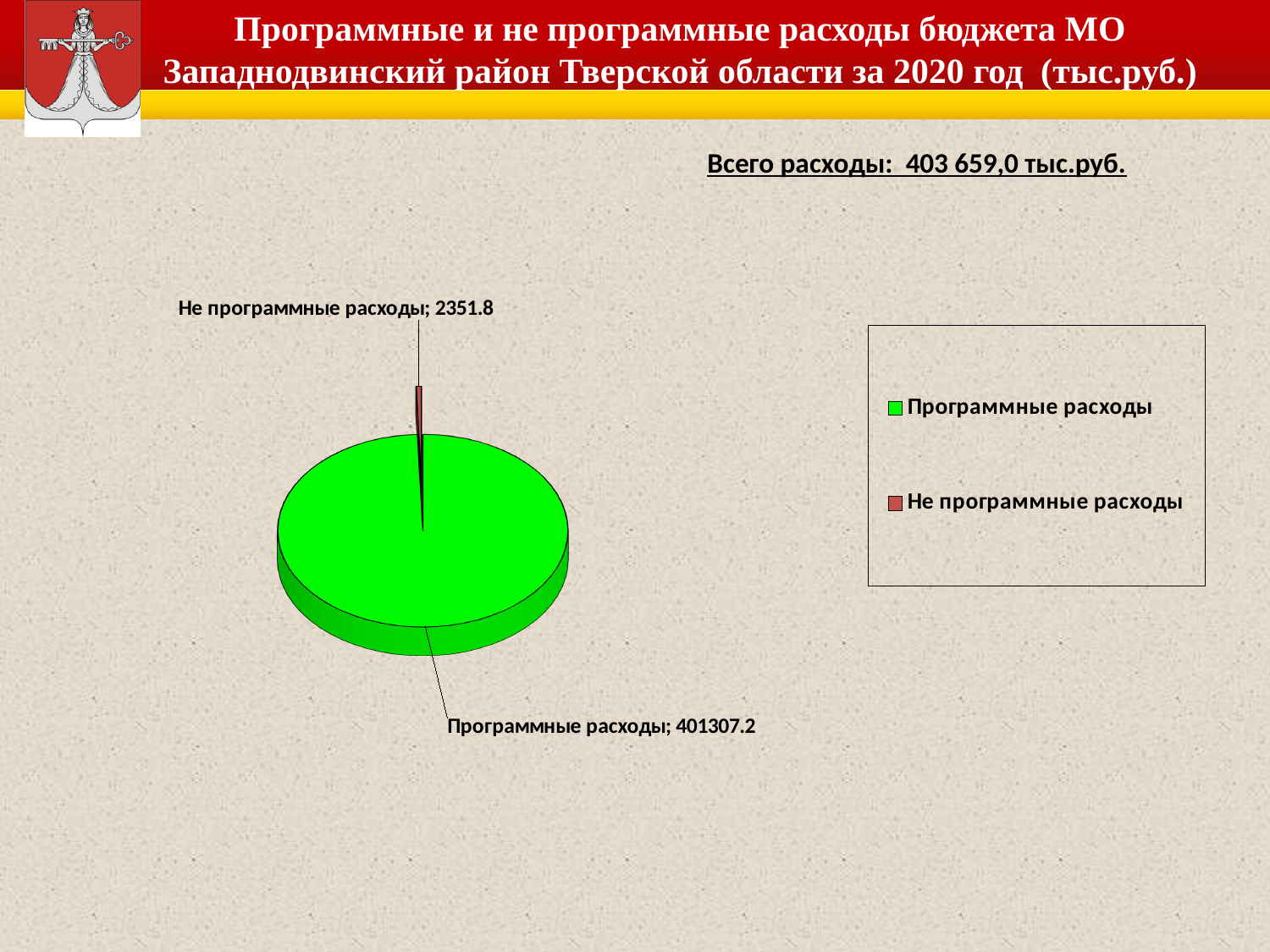
What is the value for Программные расходы? 401307.2 What is the difference between Программные расходы and Не программные расходы? 398955.4 Which is larger, Программные расходы or Не программные расходы? Программные расходы How many slices does the pie chart have? 2 How many entries does the legend list? 2 What colour is the slice for Программные расходы? green Which category has the smallest slice of the pie? Не программные расходы What colour is the slice for Не программные расходы? red Which category has the largest slice of the pie? Программные расходы What is the total of all expenditures stated on the slide? 403 659,0 тыс.руб. What type of chart is shown on the slide? pie chart What is the value for Не программные расходы? 2351.8